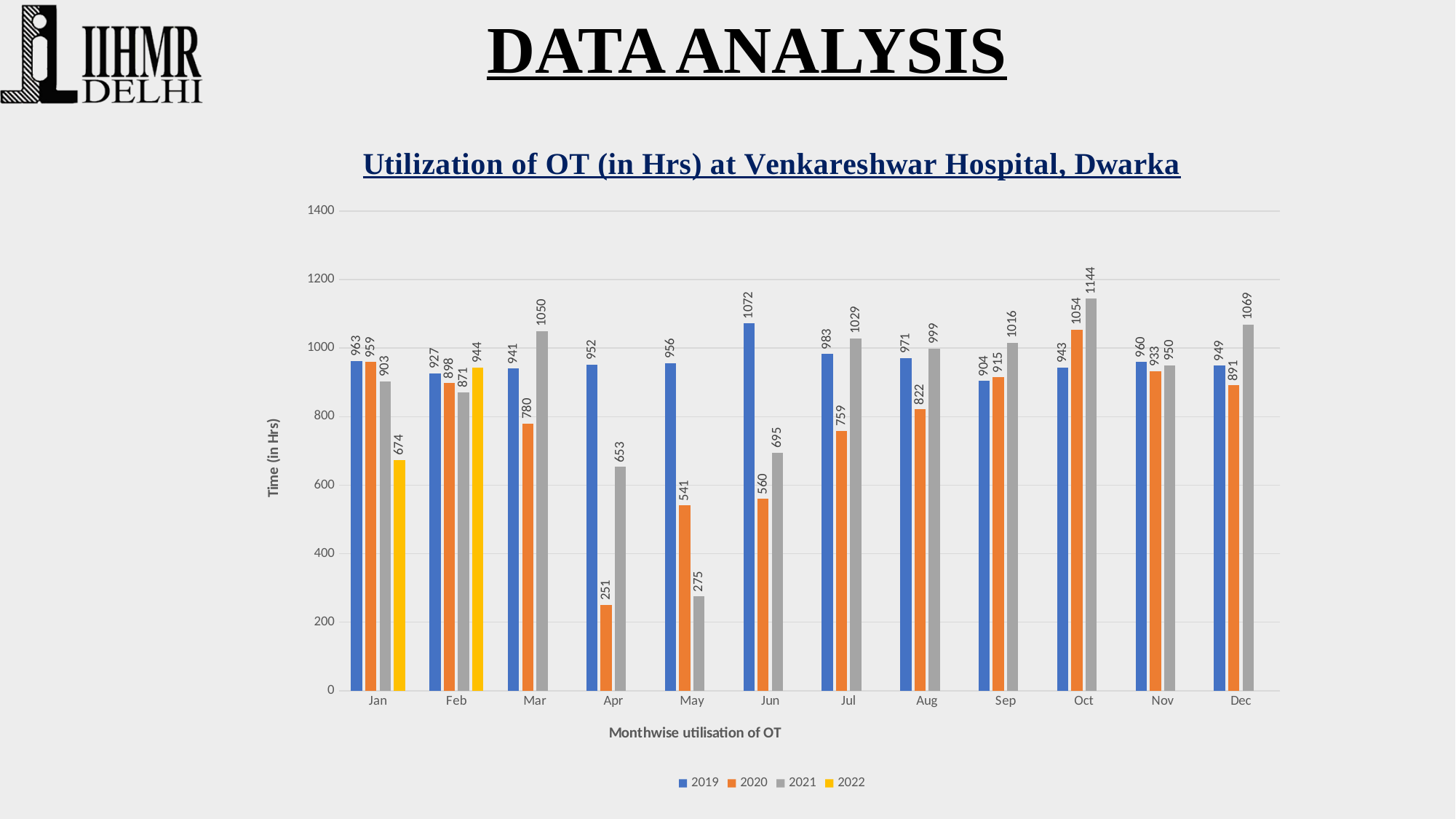
Which month has the lowest value for the 2020 series? Apr What is the OT utilization value for 2020 in Apr? 251 What is the label of the y axis? Time (in Hrs) What is the difference between the 2021 and 2020 values in May? 266 How many series does the legend list? 4 What is the OT utilization value for 2019 in Jun? 1072 Which month has the highest value for the 2021 series? Oct What kind of chart is shown on the slide? Bar chart Which is larger in Mar: the 2019 value or the 2021 value? 2021 How many months are shown on the x axis? 12 What is the OT utilization value for 2022 in Feb? 944 Is the value for 2020 in Jun greater or less than 600? less